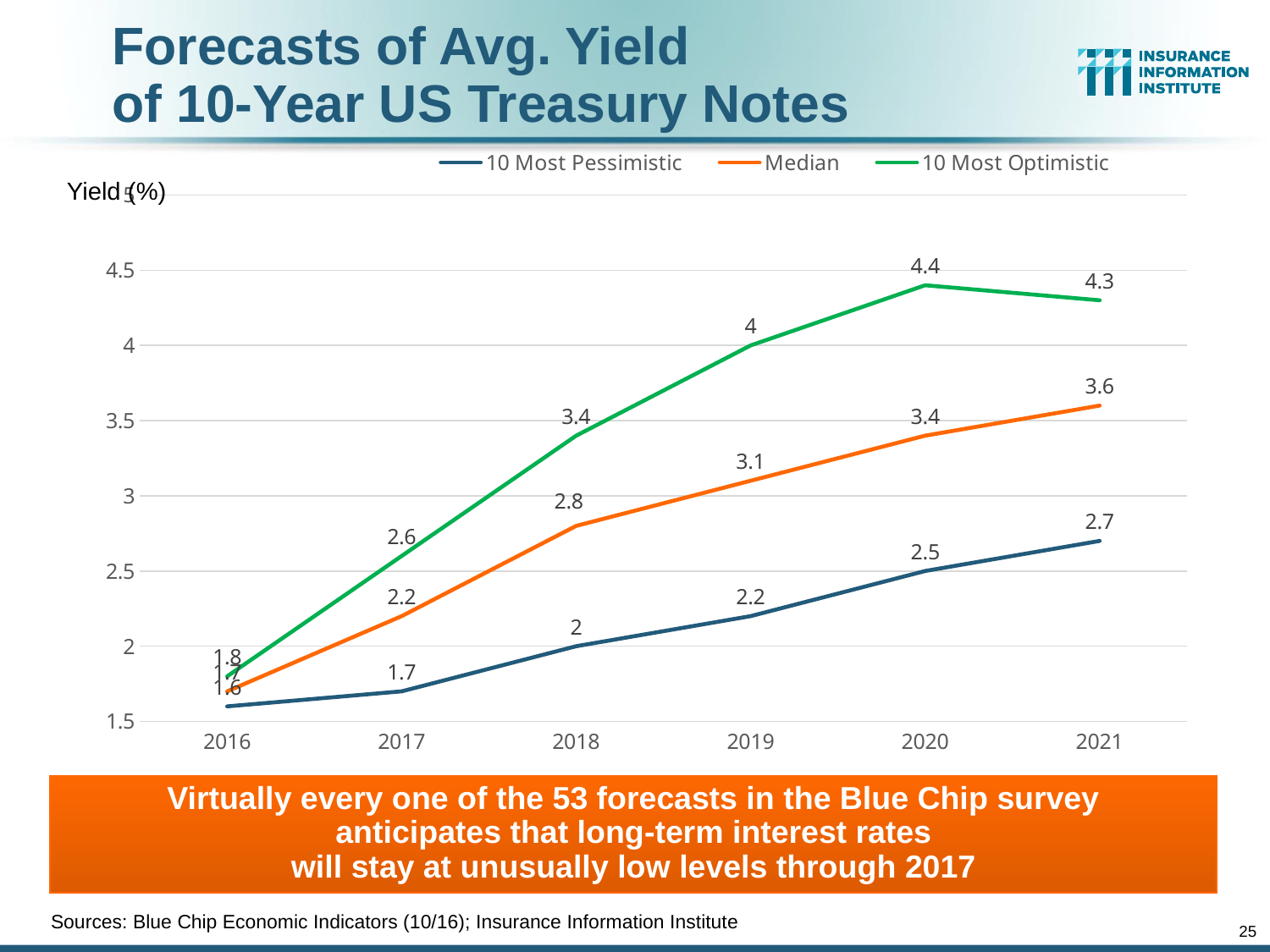
In which year is the Median forecast lowest? 2016 In which year is the 10 Most Optimistic forecast highest? 2020 Does the 10 Most Pessimistic forecast rise or fall from 2016 to 2021? rise What is the 10 Most Pessimistic forecast yield for 2021? 2.7 What colour is the Median line? orange How many series does the legend list? 3 What is the 10 Most Optimistic forecast yield for 2020? 4.4 What is the difference between the 10 Most Optimistic and 10 Most Pessimistic forecasts for 2021? 1.6 What kind of chart is shown on the slide? line chart What is the Median forecast yield for 2019? 3.1 How many years are shown on the x axis? 6 Which is larger in 2018: the Median forecast or the 10 Most Pessimistic forecast? Median